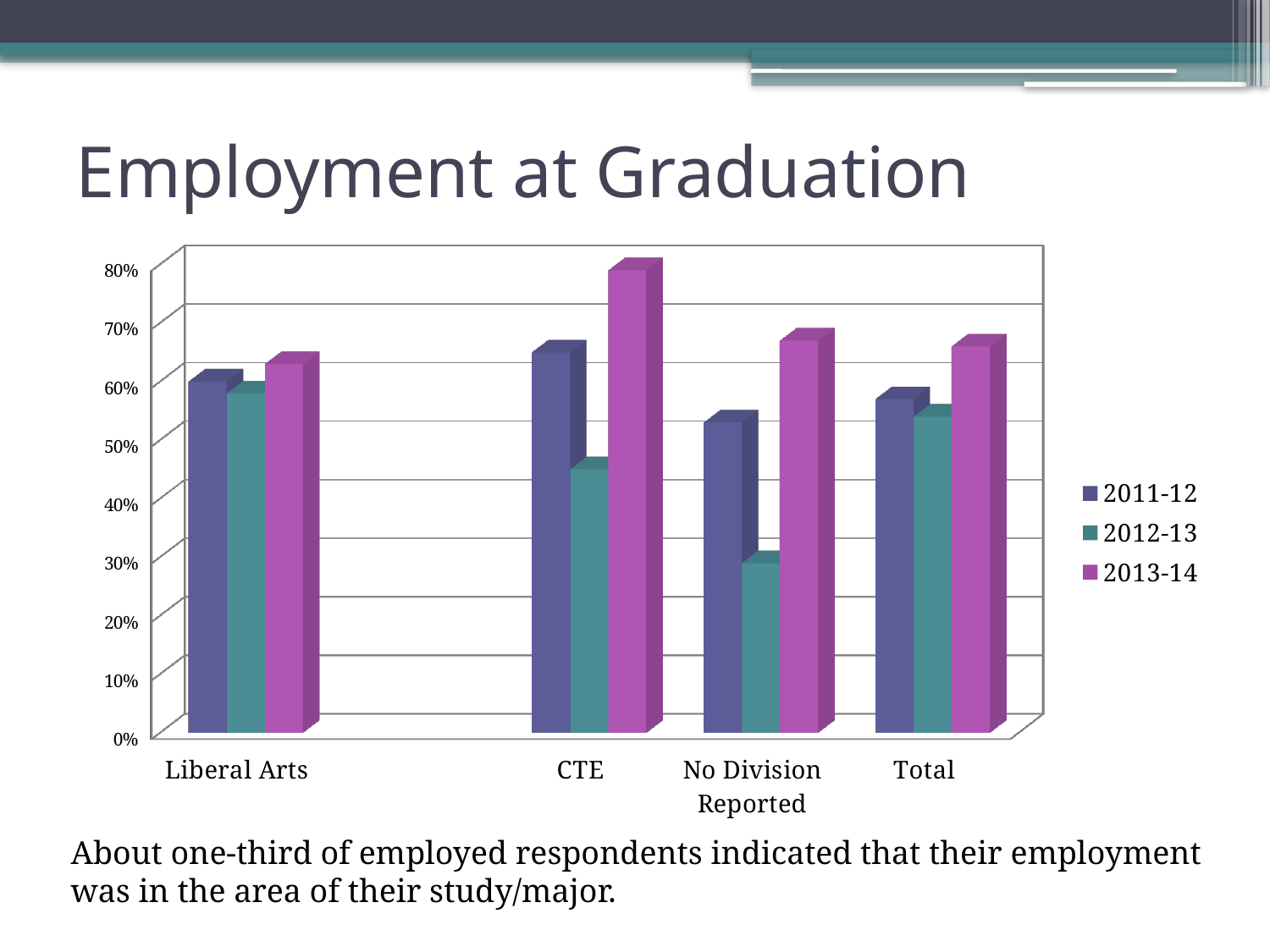
What is the title of the chart? Employment at Graduation In the CTE category, which is larger: the 2011-12 value or the 2012-13 value? 2011-12 In the Total category, which is larger: the 2013-14 value or the 2011-12 value? 2013-14 Is the 2013-14 value for CTE greater or less than 70%? greater Which series has the highest bar in the CTE category? 2013-14 How many categories are shown on the x axis of the chart? 4 How many series does the legend list? 3 Is the 2012-13 value for No Division Reported greater or less than 40%? less Which category has the highest 2013-14 bar? CTE Which series is shown in purple in the legend? 2013-14 What kind of chart is shown on the slide? Bar chart Which series has the lowest bar in the No Division Reported category? 2012-13